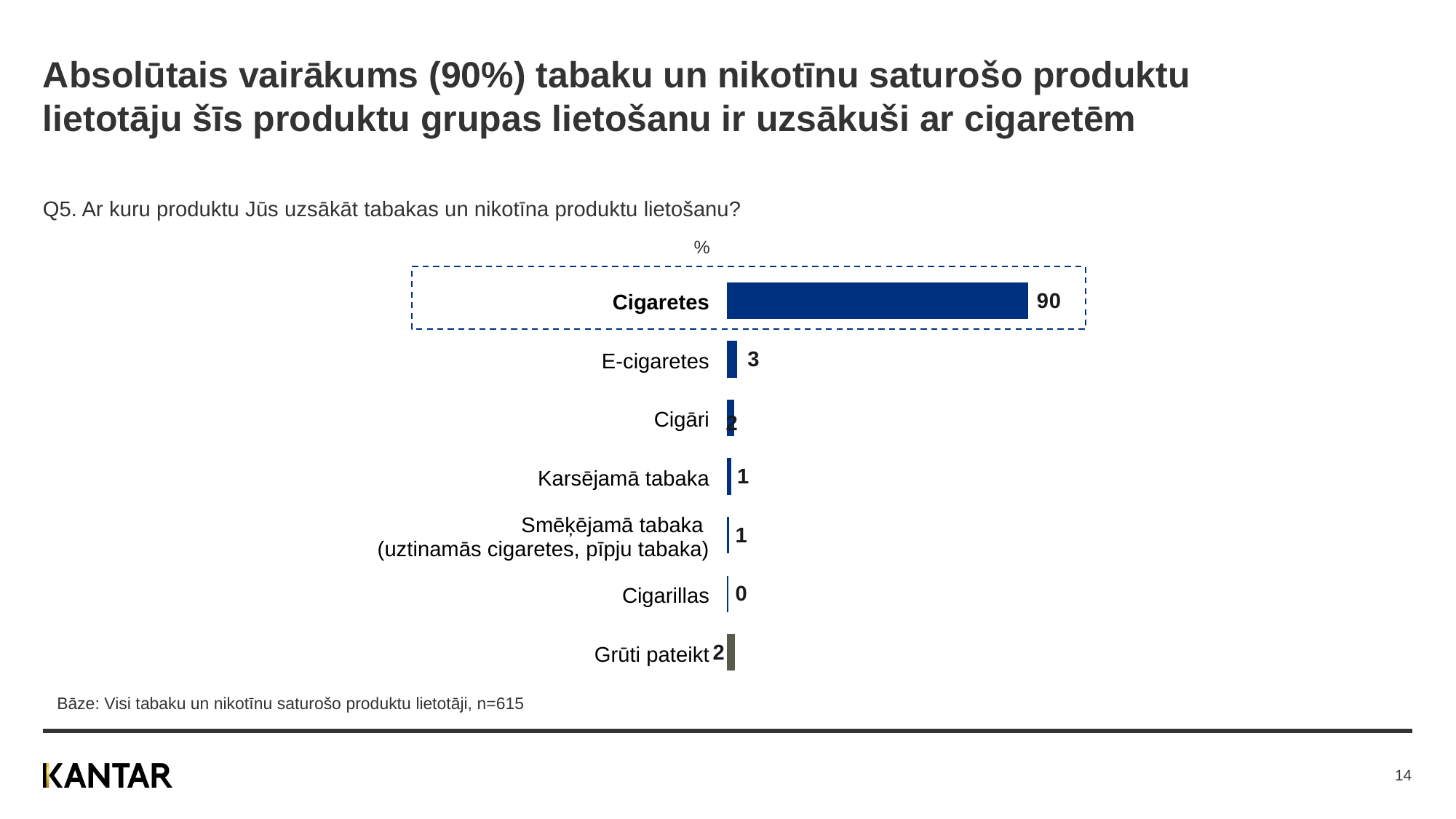
What kind of chart is shown on the slide? Bar chart What is the value for E-cigaretes? 3 What unit is indicated above the chart? % How many categories are shown in the chart? 7 What is the value for Cigarillas? 0 What is the value for Cigaretes? 90 What is the difference between the values for Cigaretes and E-cigaretes? 87 Which is larger, the value for E-cigaretes or the value for Cigāri? E-cigaretes What is the value for Grūti pateikt? 2 What is the value for Karsējamā tabaka? 1 Which category has the lowest value? Cigarillas Which category has the highest value? Cigaretes